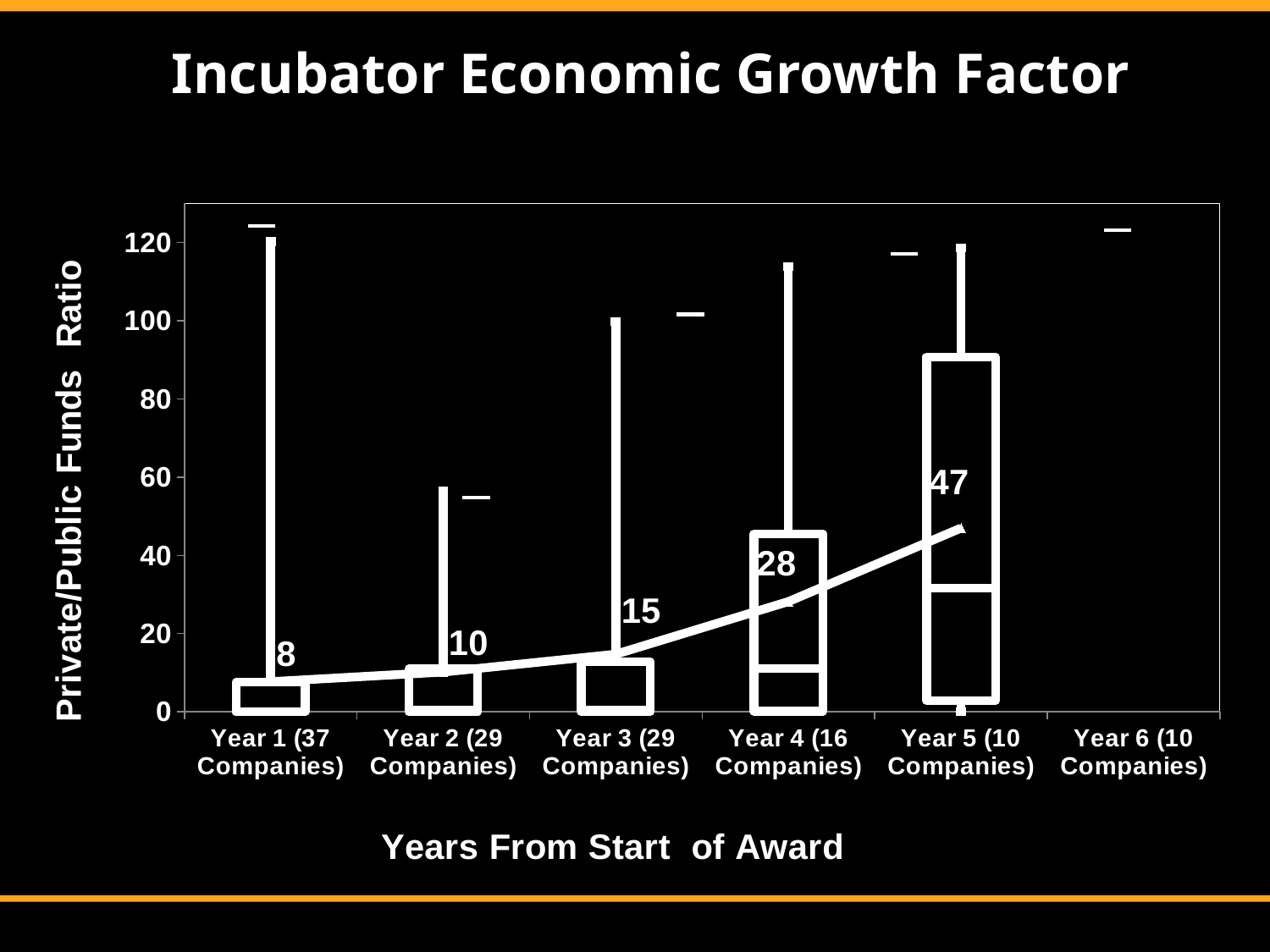
What is the labelled value for Year 1 (37 Companies)? 8 What is the difference between the labelled values for Year 5 and Year 1? 39 Which year has the highest labelled value? Year 5 (10 Companies) What is the labelled value for Year 5 (10 Companies)? 47 Do the labelled values rise or fall from Year 1 to Year 5? rise What is the label of the y axis? Private/Public Funds Ratio Which has the larger labelled value, Year 2 or Year 4? Year 4 (16 Companies) What is the labelled value for Year 3 (29 Companies)? 15 What is the difference between the labelled values for Year 4 and Year 3? 13 Which year has the lowest labelled value? Year 1 (37 Companies) What is the title of the chart? Incubator Economic Growth Factor How many year categories are shown on the x axis? 6